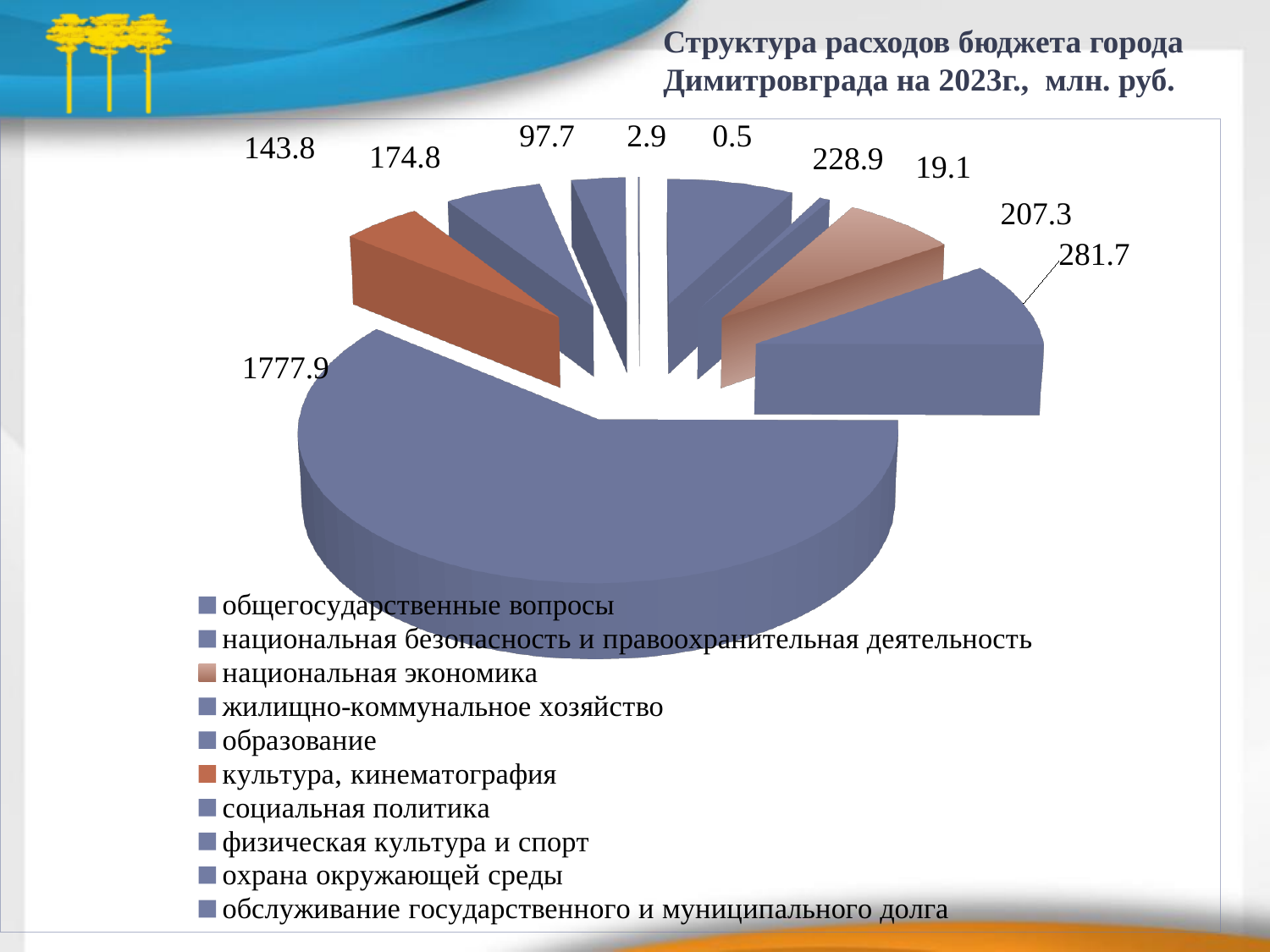
What is the title of the chart? Структура расходов бюджета города Димитровграда на 2023г., млн. руб. What kind of chart is shown on the slide? pie chart How many slices on the pie chart have a value below 10? 2 What is the smallest value shown on the pie chart? 0.5 Which legend entry is listed first? общегосударственные вопросы What is the value of the slice for культура, кинематография (the orange-brown slice)? 143.8 What is the total of all the values labelled on the pie chart? 2934.6 How many categories does the legend list? 10 What is the largest value shown on the pie chart? 1777.9 What is the difference between the values for национальная экономика (207.3) and культура, кинематография (143.8)? 63.5 Which is larger: the slice for национальная экономика or the slice for культура, кинематография? национальная экономика What is the value of the slice for национальная экономика (the salmon-coloured slice)? 207.3